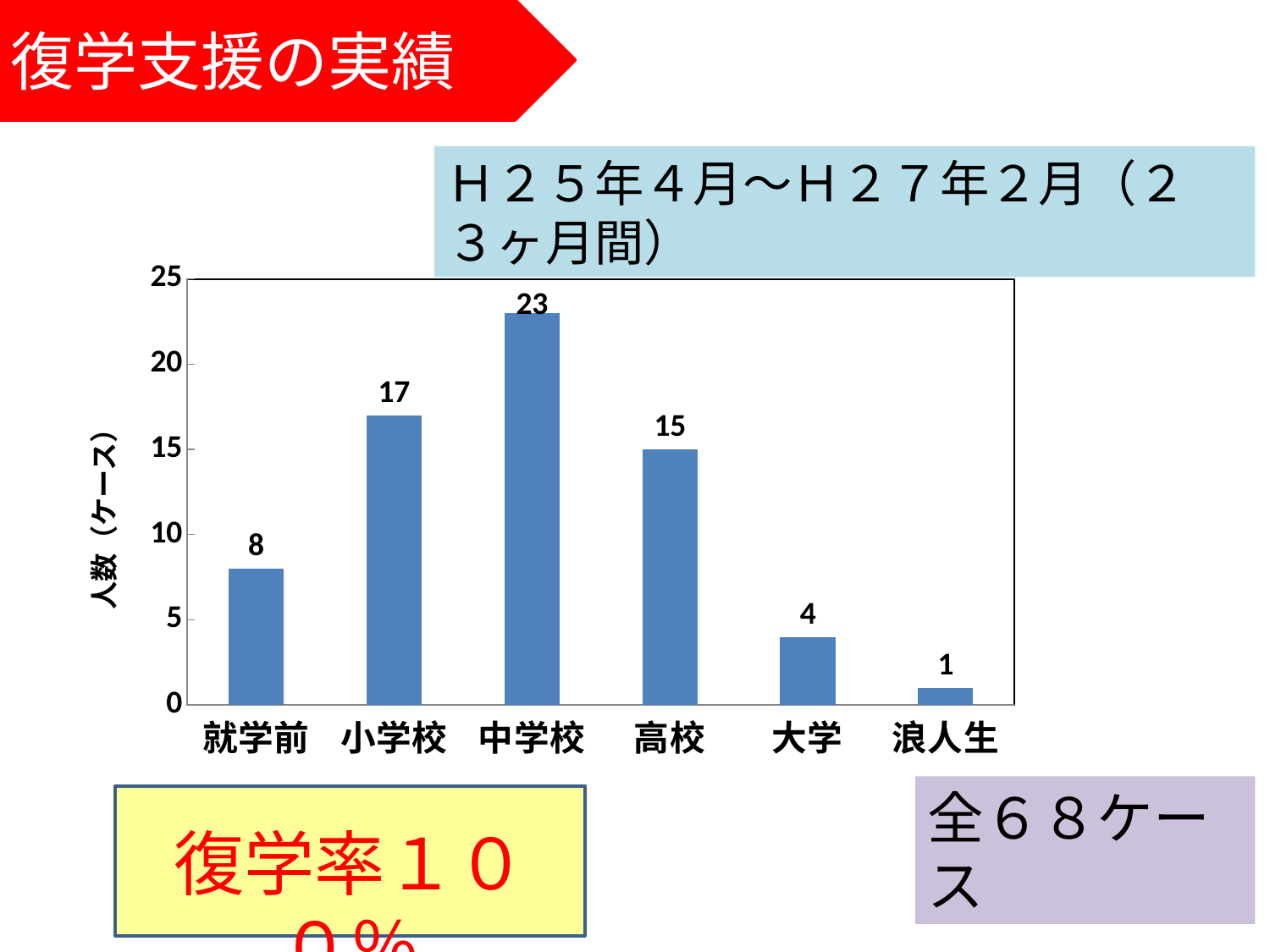
What is the label of the vertical axis? 人数（ケース） How many categories are shown on the x axis? 6 What is the difference between the values for 中学校 and 就学前? 15 What is the value for 大学? 4 Which is larger, the value for 小学校 or the value for 高校? 小学校 Which category has the lowest value? 浪人生 What kind of chart is shown on the slide? bar chart What is the difference between the values for 小学校 and 高校? 2 What is the value for 就学前? 8 What is the value for 中学校? 23 Is the value for 高校 greater or less than 10? greater Which category has the highest value? 中学校